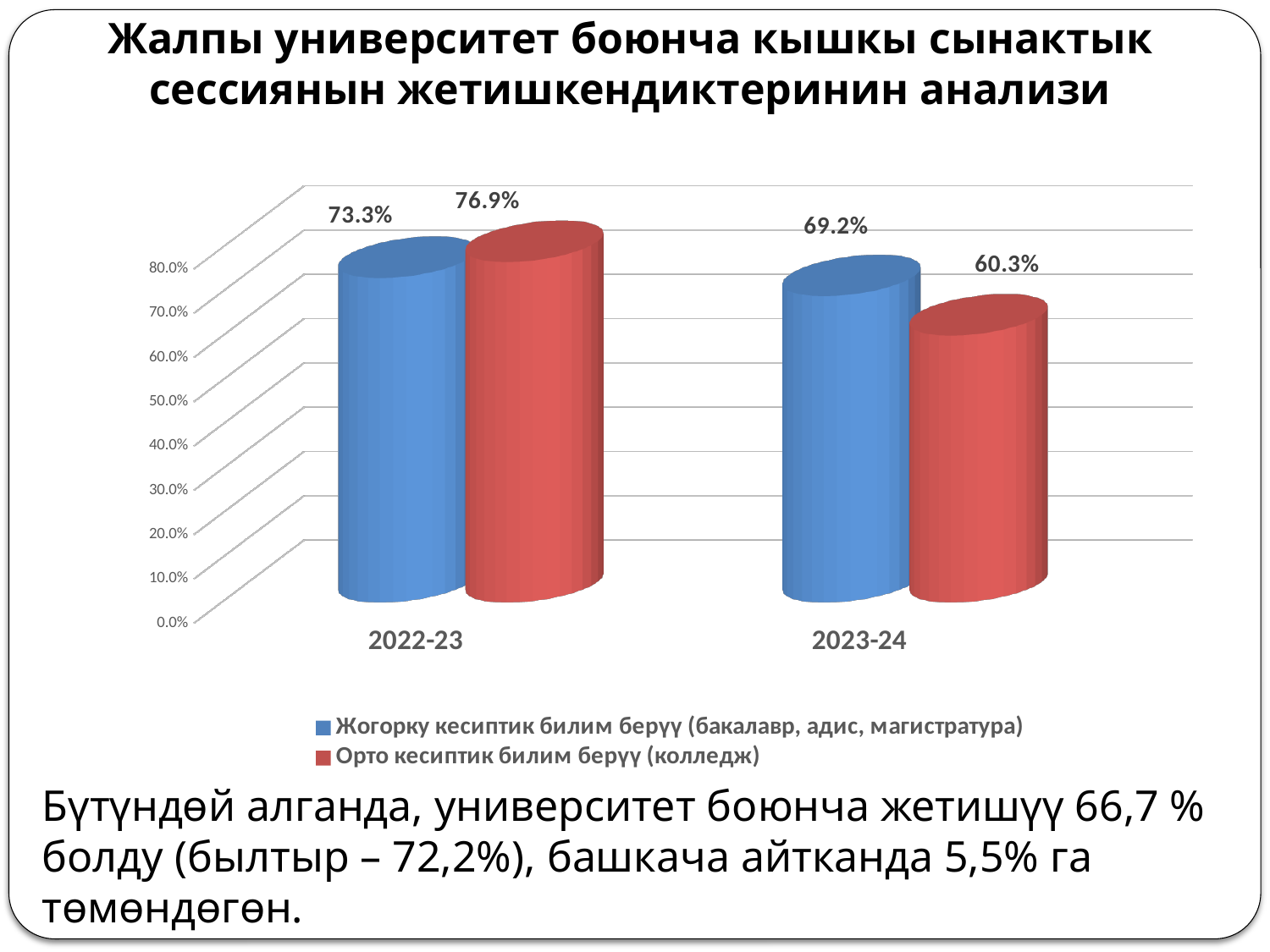
What is the value for Жогорку кесиптик билим берүү (бакалавр, адис, магистратура) in 2023-24? 69.2% What is the value for Орто кесиптик билим берүү (колледж) in 2023-24? 60.3% Which is larger: the Жогорку кесиптик билим берүү value in 2022-23 or in 2023-24? 2022-23 Which series has the lowest value in 2023-24? Орто кесиптик билим берүү (колледж) How many series does the legend list? 2 How many categories are shown on the x axis? 2 What is the difference between the Орто кесиптик билим берүү (колледж) values for 2022-23 and 2023-24? 16.6% What kind of chart is shown on the slide? Bar chart What is the value for Орто кесиптик билим берүү (колледж) in 2022-23? 76.9% Do the values for Орто кесиптик билим берүү (колледж) rise or fall from 2022-23 to 2023-24? Fall Which series has the highest value in 2022-23? Орто кесиптик билим берүү (колледж) What is the value for Жогорку кесиптик билим берүү (бакалавр, адис, магистратура) in 2022-23? 73.3%